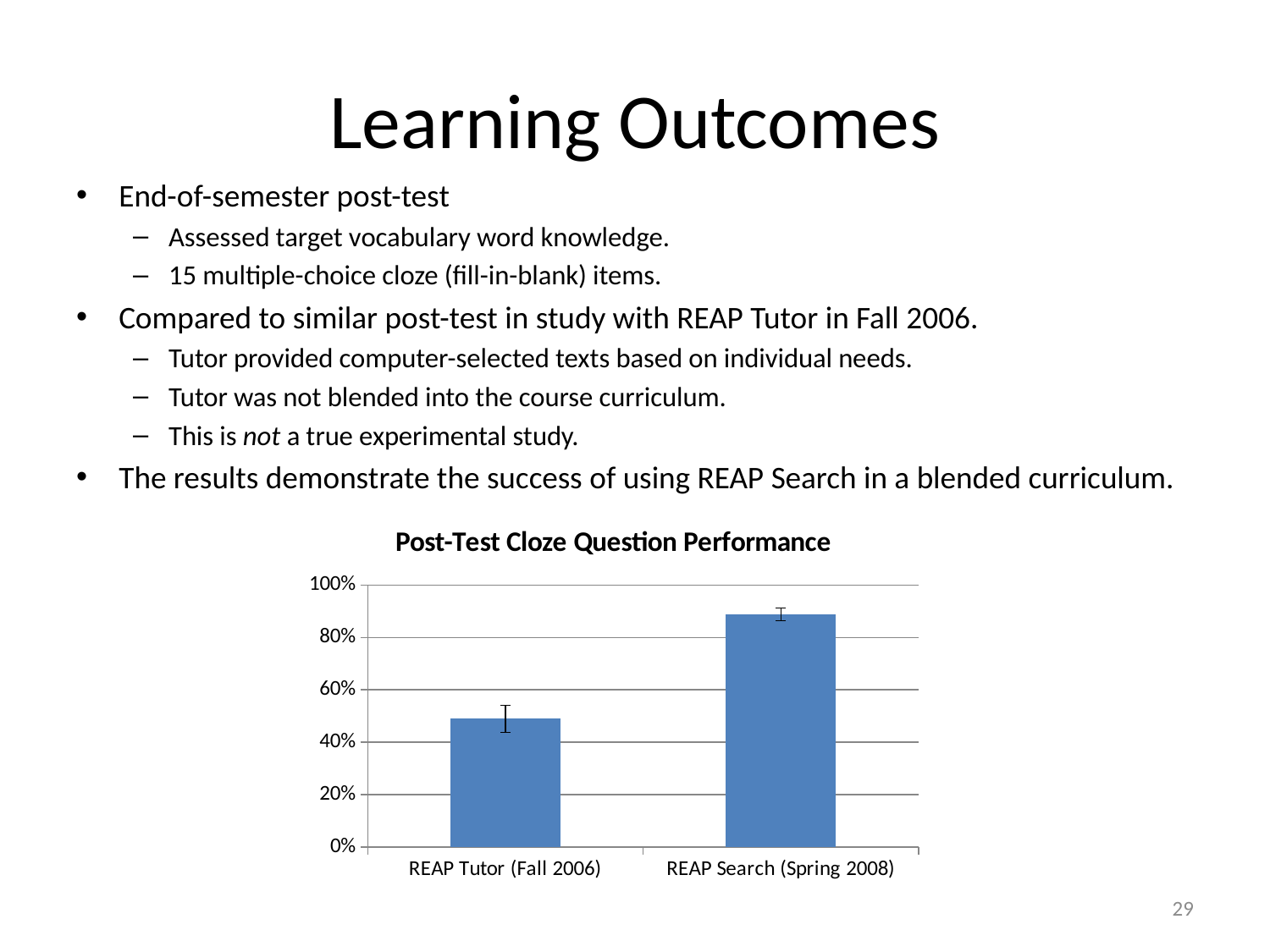
Do the values rise or fall from left to right along the x axis? rise What kind of chart is shown on the slide? bar chart Which is larger, the value for REAP Tutor (Fall 2006) or the value for REAP Search (Spring 2008)? REAP Search (Spring 2008) Is the value for REAP Tutor (Fall 2006) greater or less than 60%? less How many categories are shown on the x axis of the chart? 2 Is the value for REAP Tutor (Fall 2006) greater or less than 40%? greater What is the title of the chart? Post-Test Cloze Question Performance Is the value for REAP Search (Spring 2008) greater or less than 80%? greater Which category has the lowest value in the chart? REAP Tutor (Fall 2006) What is the highest tick label shown on the y axis of the chart? 100% Which category has the highest value in the chart? REAP Search (Spring 2008)